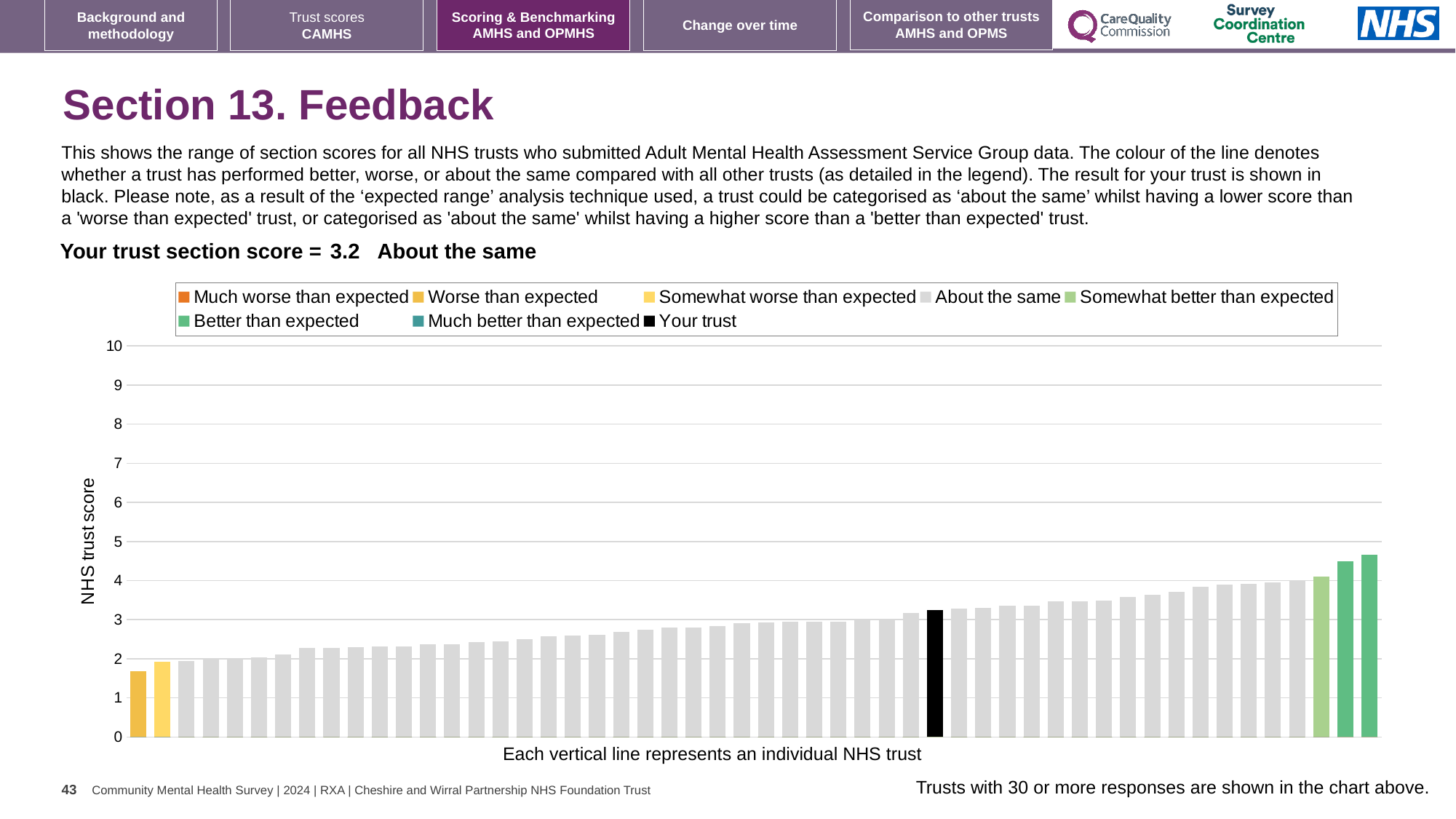
What kind of chart is shown on the slide? bar chart Do the bar values rise or fall moving from left to right along the x axis? rise Is the value of the black 'Your trust' bar greater or less than 4? less How many bars are coloured black in the chart? 1 Is the value of the shortest bar (leftmost) greater or less than 2? less What is the label on the y axis of the chart? NHS trust score What is the label on the x axis of the chart? Each vertical line represents an individual NHS trust How many entries does the chart legend list? 8 What is the section score for your trust shown on the slide? 3.2 Is the value of the black 'Your trust' bar greater or less than 3? greater Which is larger: the black 'Your trust' bar or the leftmost bar? the black 'Your trust' bar